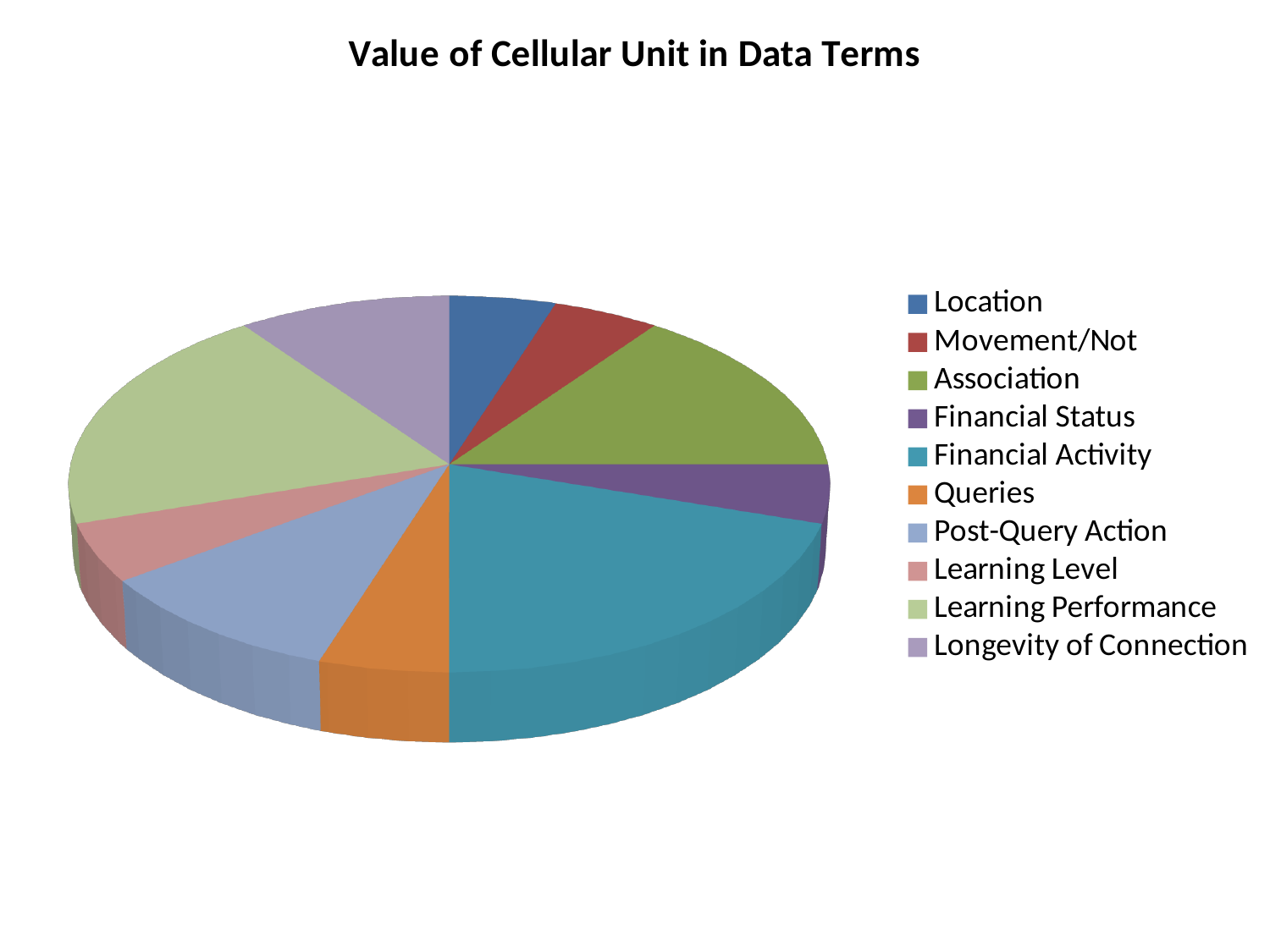
Which slice is larger, Association or Financial Status? Association Which slice is larger, Financial Activity or Location? Financial Activity What colour is the Queries slice in the pie chart? orange Which slice is larger, Post-Query Action or Learning Level? Post-Query Action What kind of chart is shown on the slide? pie chart How many categories does the pie chart have? 10 What is the title of the chart? Value of Cellular Unit in Data Terms